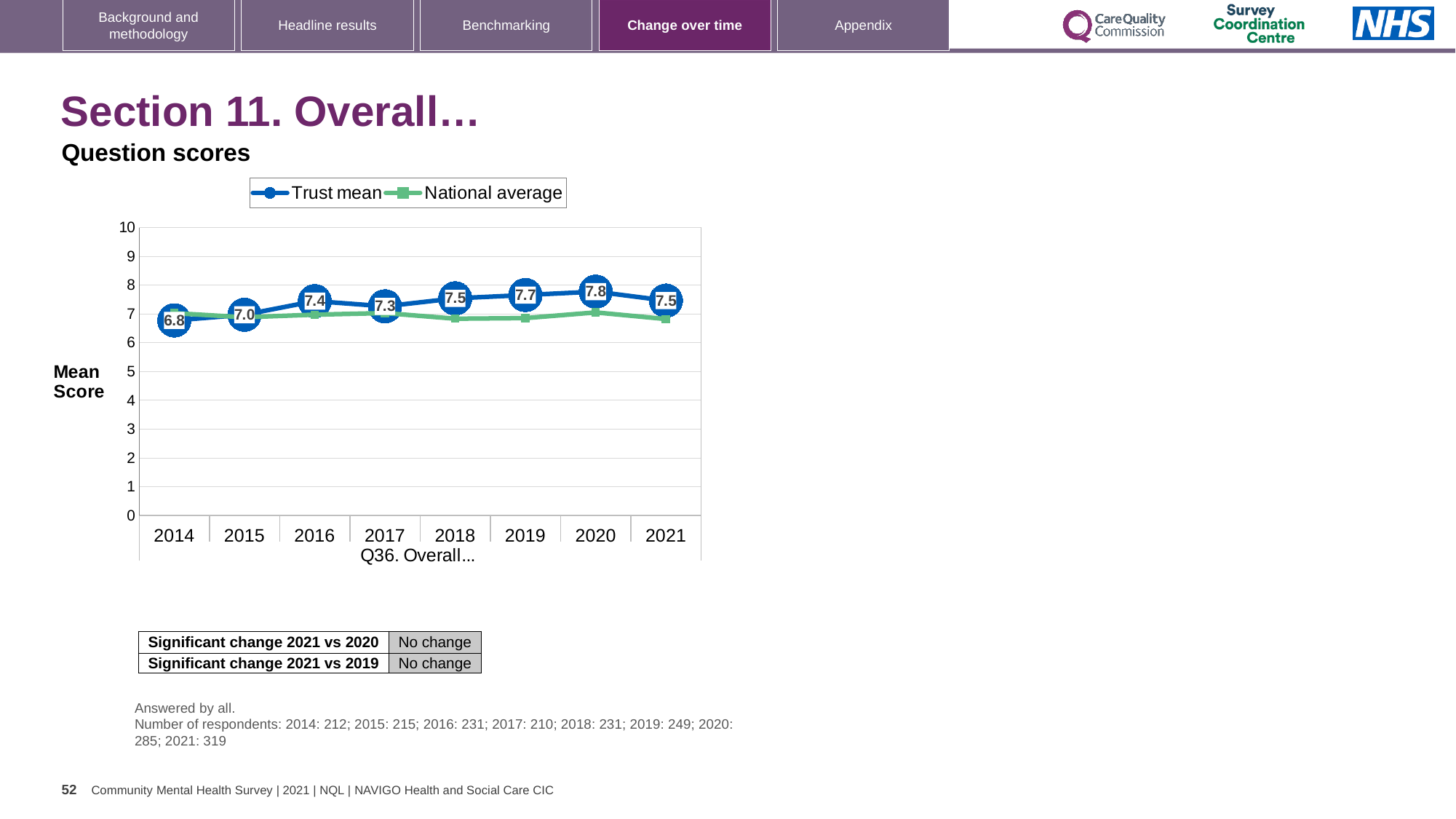
In which year is the Trust mean lowest? 2014 Is the National average for 2018 greater or less than 8? less What is the difference between the Trust mean in 2020 and in 2014? 1.0 How many series does the legend list? 2 What kind of chart is shown? Line chart How many years are shown on the x axis? 8 What is the Trust mean for 2020? 7.8 Which is larger, the Trust mean in 2016 or in 2017? 2016 Does the Trust mean rise or fall from 2014 to 2020? Rise In which year is the Trust mean highest? 2020 What is the Trust mean for 2021? 7.5 What is the Trust mean for 2014? 6.8